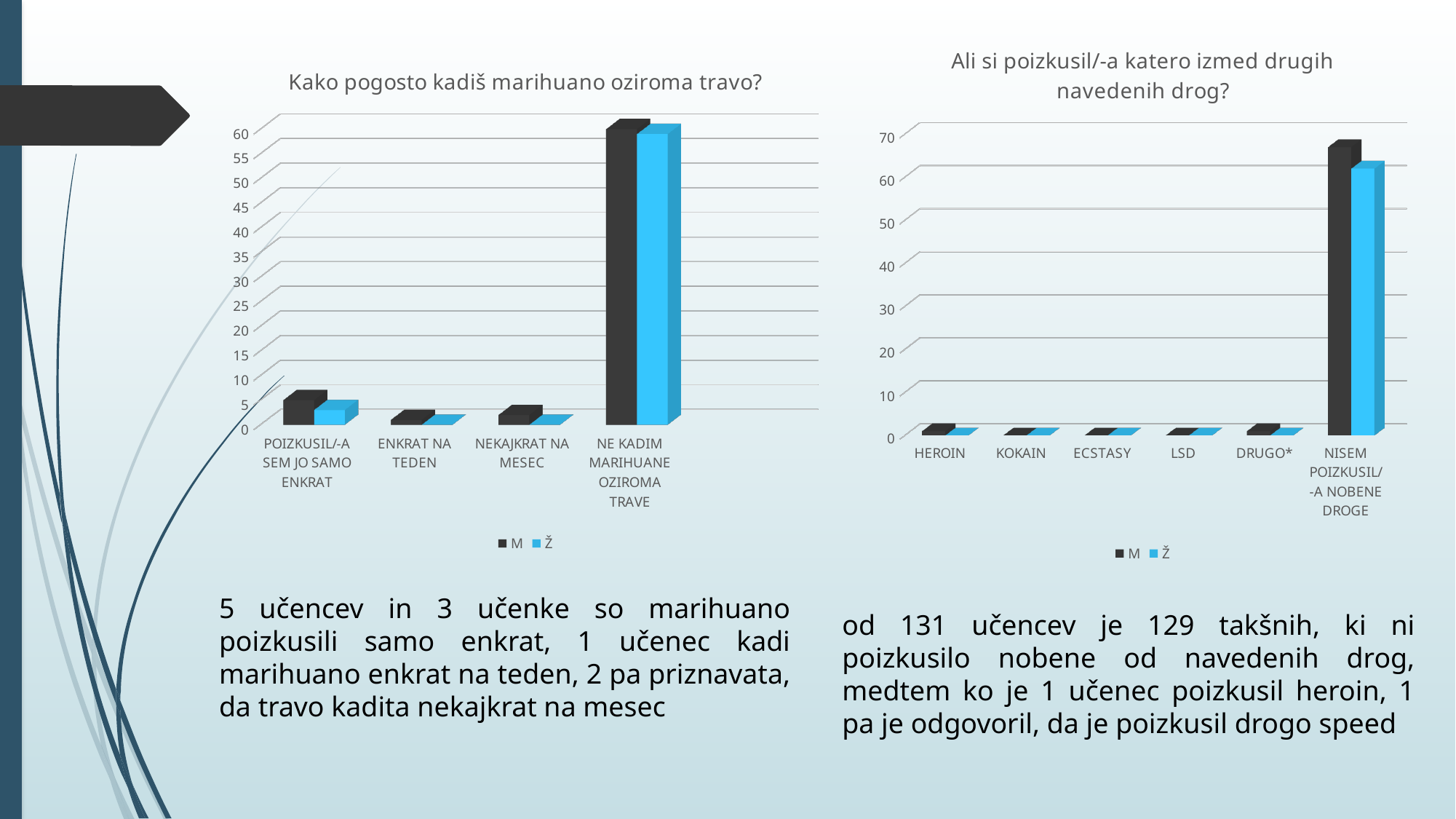
In the chart "Ali si poizkusil/-a katero izmed drugih navedenih drog?", is the M value for NISEM POIZKUSIL/-A NOBENE DROGE greater or less than 60? greater In the chart "Ali si poizkusil/-a katero izmed drugih navedenih drog?", is the Ž value for KOKAIN greater or less than 10? less In the chart "Ali si poizkusil/-a katero izmed drugih navedenih drog?", what are the two legend entries? M and Ž In the chart "Kako pogosto kadiš marihuano oziroma travo?", is the M value for NE KADIM MARIHUANE OZIROMA TRAVE greater or less than 50? greater In the chart "Kako pogosto kadiš marihuano oziroma travo?", how many categories are shown on the x axis? 4 In the chart "Kako pogosto kadiš marihuano oziroma travo?", what colour are the bars for the Ž series? light blue In the chart "Kako pogosto kadiš marihuano oziroma travo?", which category has the highest bars? NE KADIM MARIHUANE OZIROMA TRAVE In the chart "Kako pogosto kadiš marihuano oziroma travo?", how many series does the legend list? 2 In the chart "Ali si poizkusil/-a katero izmed drugih navedenih drog?", how many categories are shown on the x axis? 6 What kind of chart is the chart titled "Kako pogosto kadiš marihuano oziroma travo?"? bar chart In the chart "Ali si poizkusil/-a katero izmed drugih navedenih drog?", which category has the highest bars? NISEM POIZKUSIL/-A NOBENE DROGE